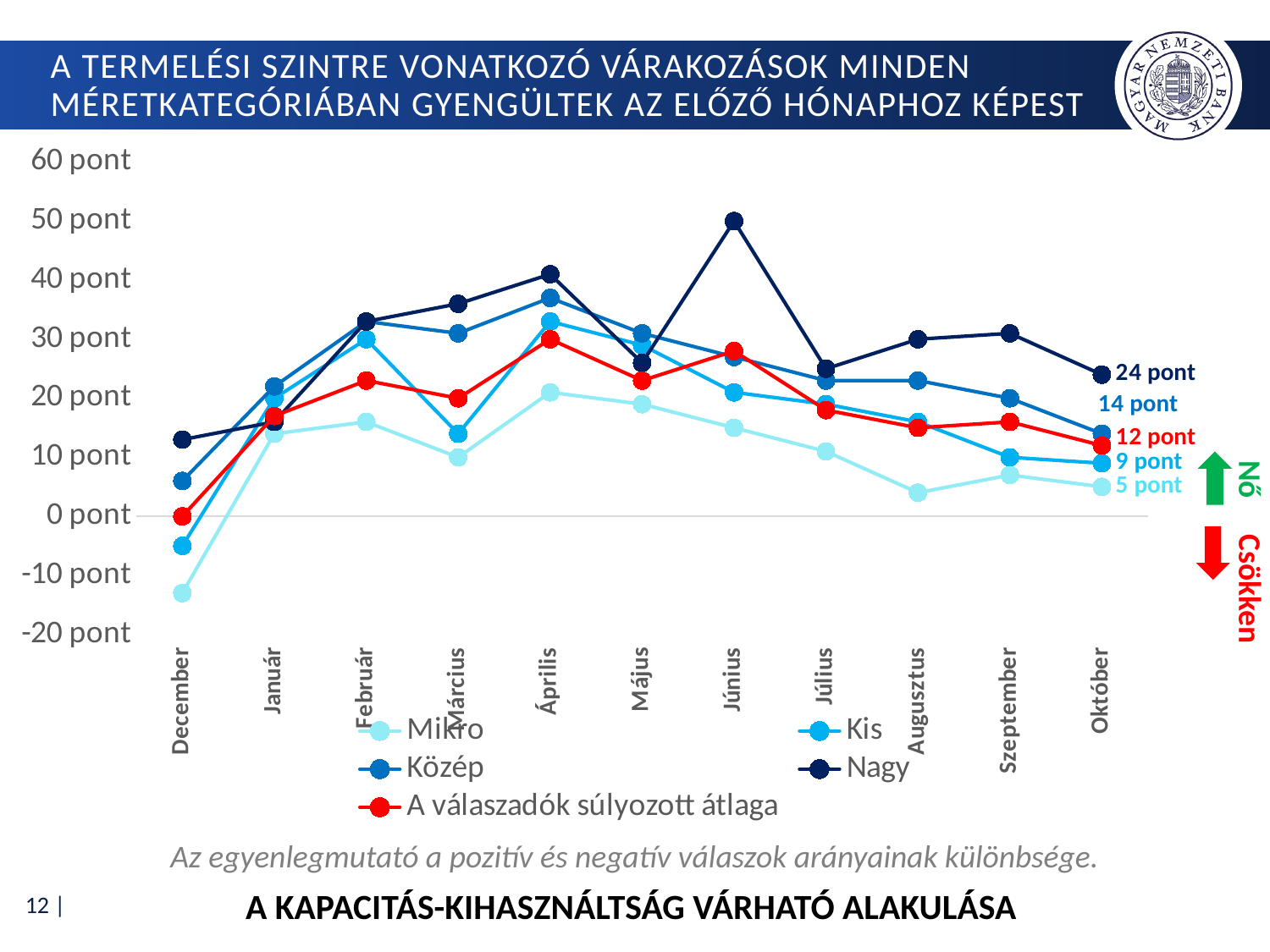
What is the value for the Kis series in Október? 9 pont What is the difference between the Nagy and Mikro values in Október? 19 pont What is the difference between the Közép and Kis values in Október? 5 pont What is the value for A válaszadók súlyozott átlaga in Október? 12 pont What kind of chart is shown on the slide? line chart In which month does the Nagy series reach its highest value? Június How many months are shown on the x axis? 11 How many series does the legend list? 5 Is the value for Nagy in Június greater or less than 40 pont? greater Which series has the highest value in Október? Nagy What is the value for the Nagy series in Október? 24 pont What is the value for the Mikro series in Október? 5 pont